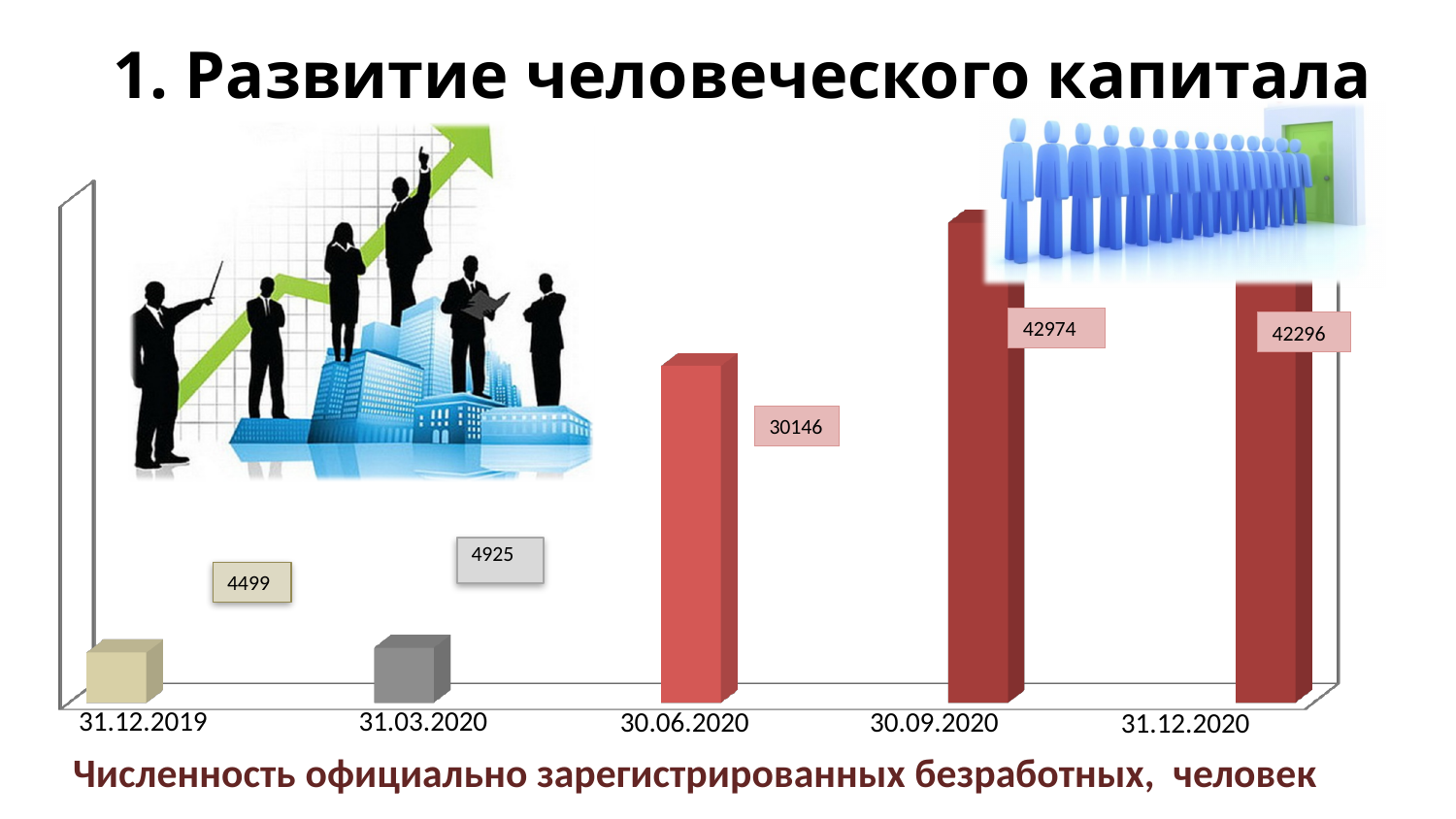
What is the value for 31.12.2019? 4499 Which date has the lowest value? 31.12.2019 Which is larger, the value for 30.09.2020 or the value for 31.12.2020? 30.09.2020 What is the value for 30.06.2020? 30146 What is the value for 31.12.2020? 42296 What kind of chart is shown on the slide? bar chart How many dates are shown on the chart? 5 Which date has the highest value? 30.09.2020 What is the difference between the values for 31.03.2020 and 31.12.2019? 426 What is the value for 30.09.2020? 42974 What is the difference between the values for 30.09.2020 and 31.12.2020? 678 What does the caption below the chart say the chart shows? Численность официально зарегистрированных безработных, человек